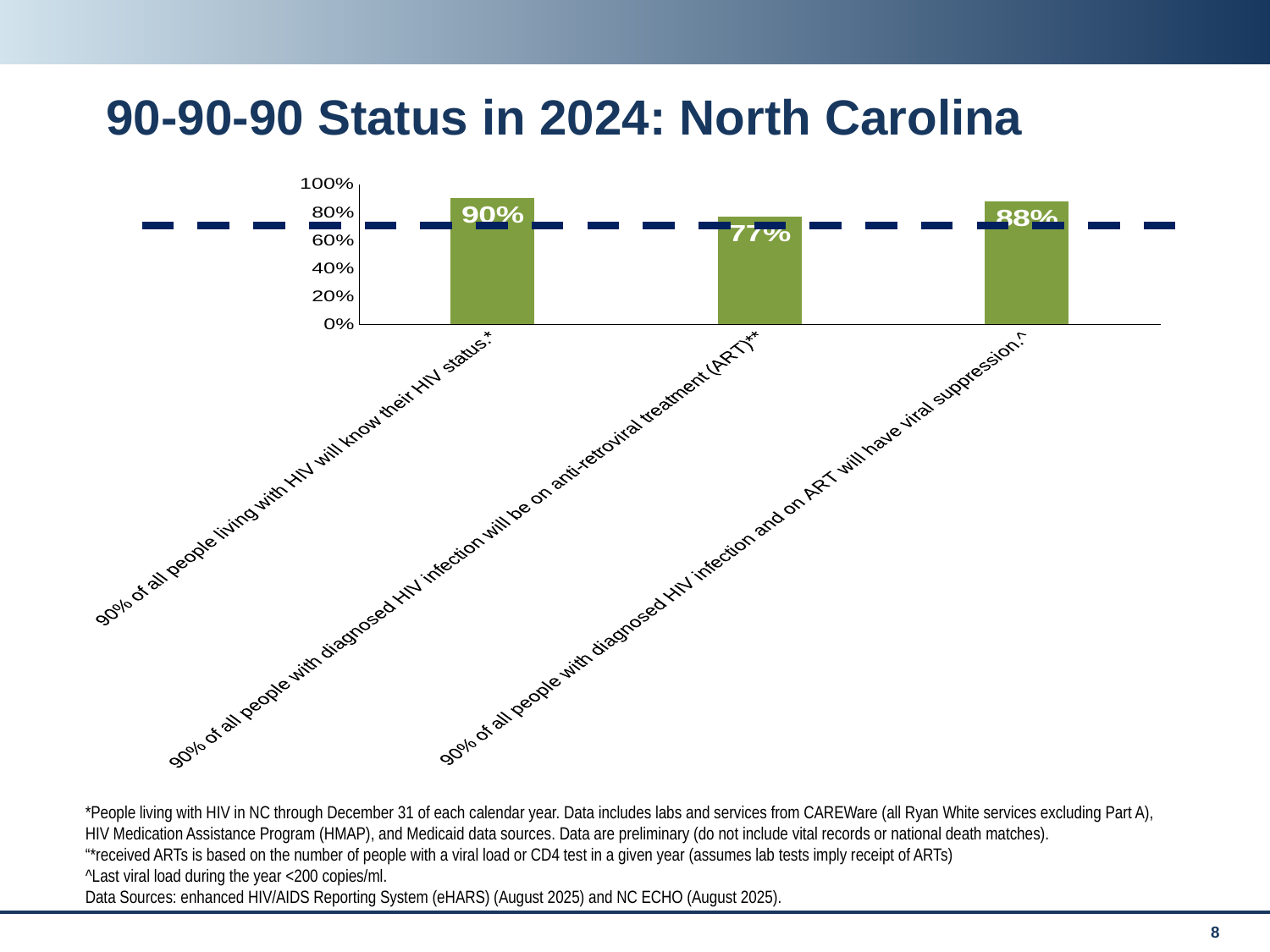
What kind of chart is shown on the slide? Bar chart What percentage of all people living with HIV know their HIV status? 90% Which category has the highest value? 90% of all people living with HIV will know their HIV status How many bars are shown in the chart? 3 Which is larger: the value for knowing HIV status or the value for viral suppression? Knowing HIV status What is the difference between the value for viral suppression and the value for being on ART? 11% What is the title of the slide? 90-90-90 Status in 2024: North Carolina Which category has the lowest value? 90% of all people with diagnosed HIV infection will be on anti-retroviral treatment (ART) What percentage of all people with diagnosed HIV infection are on anti-retroviral treatment (ART)? 77% What percentage of all people with diagnosed HIV infection and on ART have viral suppression? 88% What is the difference between the value for knowing HIV status and the value for being on ART? 13% Is the value for people on anti-retroviral treatment (ART) greater or less than 80%? less